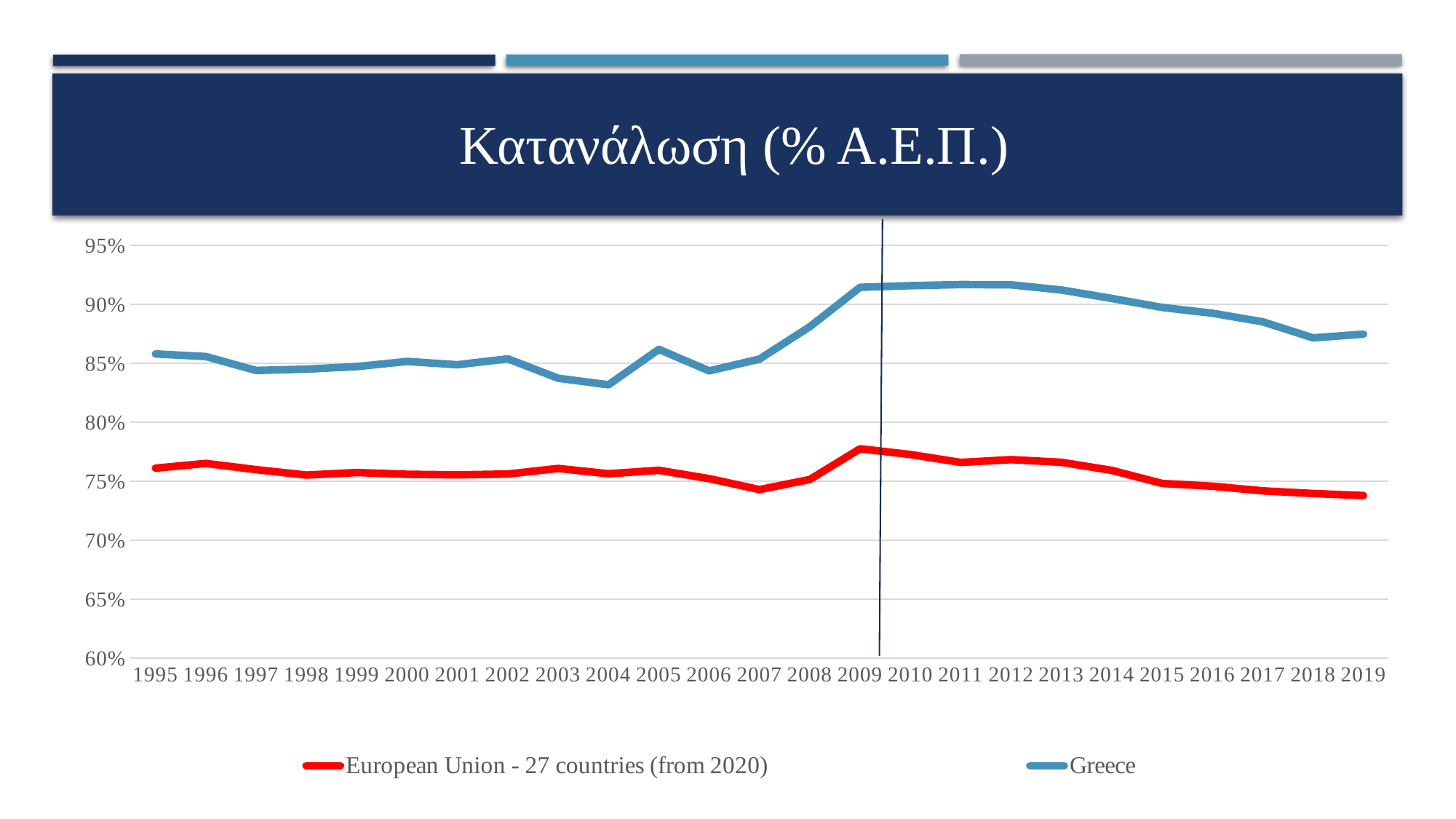
Is the value for Greece in 2004 greater or less than 85%? less In which year does the Greece series reach its lowest value? 2004 What kind of chart is shown on the slide? Line chart In 2010, which series has the larger value, Greece or European Union - 27 countries (from 2020)? Greece Is the value for Greece in 2009 greater or less than 90%? greater How many series does the legend list? 2 Is the value for European Union - 27 countries (from 2020) in 2007 greater or less than 75%? less In which year does the European Union - 27 countries (from 2020) series reach its highest value? 2009 What is the title of the chart? Κατανάλωση (% Α.Ε.Π.) How many years are shown on the x axis? 25 Does the Greece series rise or fall from 2012 to 2019? Fall